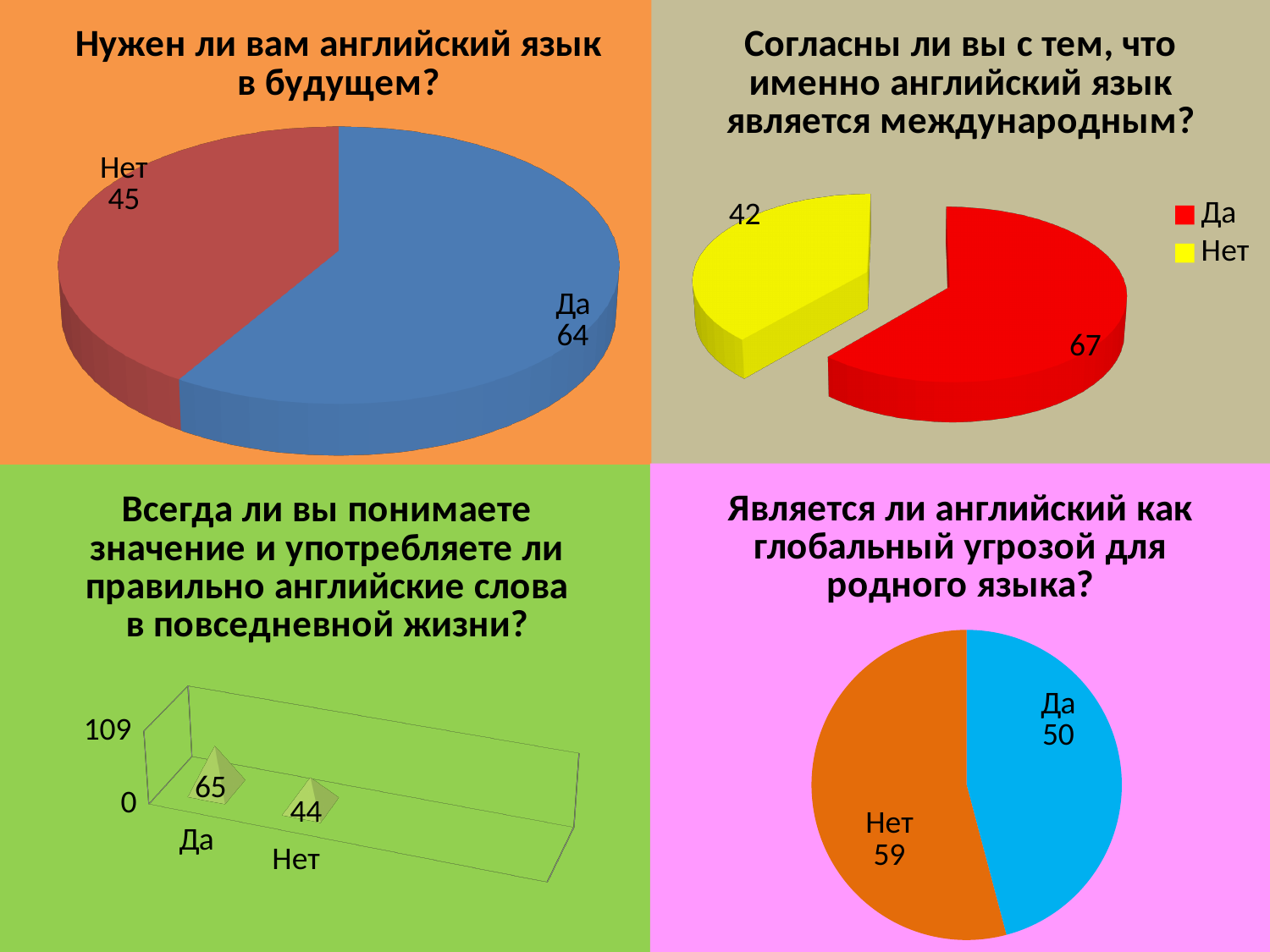
In the top-right pie chart, which category has the smaller value? Нет What kind of chart is shown in the bottom-left panel ("Всегда ли вы понимаете значение...")? Bar chart In the bottom-left chart, what is the value for "Нет"? 44 How many categories does the bottom-right pie chart show? 2 In the bottom-right pie chart, which category has the larger value, "Да" or "Нет"? Нет In the top-right pie chart ("Согласны ли вы с тем, что именно английский язык является международным?"), what is the value for "Да"? 67 In the top-left pie chart ("Нужен ли вам английский язык в будущем?"), what is the value for "Да"? 64 In the bottom-right pie chart ("Является ли английский как глобальный угрозой для родного языка?"), what is the value for "Нет"? 59 In the top-left pie chart, what is the difference between the "Да" and "Нет" values? 19 In the top-right pie chart, what colour represents "Нет" according to the legend? Yellow In the top-left pie chart ("Нужен ли вам английский язык в будущем?"), what is the value for "Нет"? 45 In the bottom-left chart, what is the value for "Да"? 65